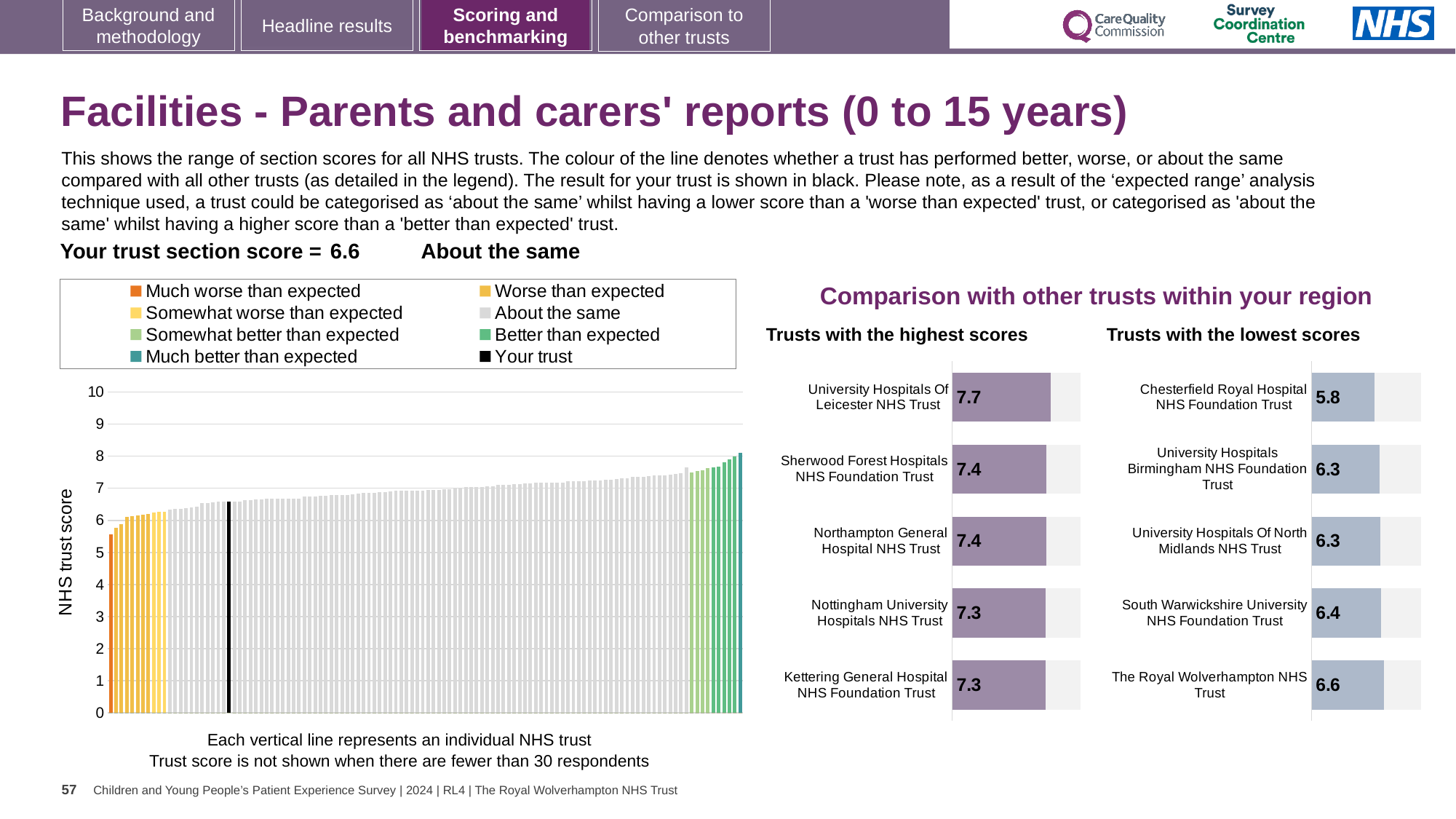
How many entries does the legend of the large chart on the left list? 8 In the large chart on the left, do the trust scores rise or fall from left to right along the x axis? Rise In the 'Trusts with the highest scores' chart, what is the score for Kettering General Hospital NHS Foundation Trust? 7.3 In the 'Trusts with the lowest scores' chart, which has the larger score: Chesterfield Royal Hospital NHS Foundation Trust or South Warwickshire University NHS Foundation Trust? South Warwickshire University NHS Foundation Trust In the 'Trusts with the highest scores' chart, which trust has the highest score? University Hospitals Of Leicester NHS Trust In the 'Trusts with the highest scores' chart, what is the difference between the scores of University Hospitals Of Leicester NHS Trust and Kettering General Hospital NHS Foundation Trust? 0.4 What kind of chart is the large chart on the left with the 'NHS trust score' axis? Bar chart In the 'Trusts with the highest scores' chart, how many trusts are listed? 5 In the 'Trusts with the lowest scores' chart, what is the score for Chesterfield Royal Hospital NHS Foundation Trust? 5.8 In the 'Trusts with the lowest scores' chart, which trust has the lowest score? Chesterfield Royal Hospital NHS Foundation Trust In the 'Trusts with the lowest scores' chart, what is the difference between the scores of The Royal Wolverhampton NHS Trust and Chesterfield Royal Hospital NHS Foundation Trust? 0.8 In the 'Trusts with the highest scores' chart, what is the score for University Hospitals Of Leicester NHS Trust? 7.7